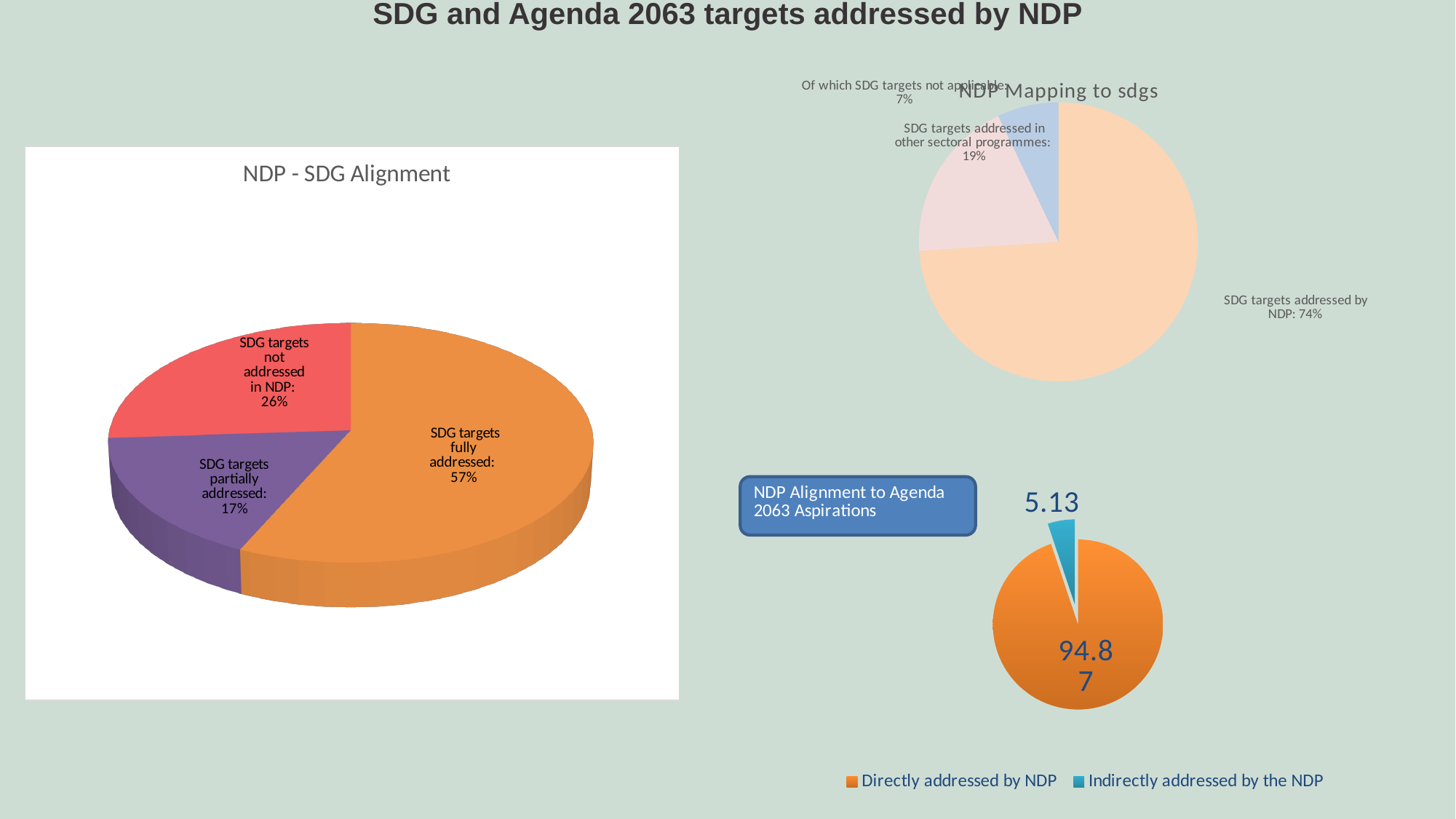
What type of chart is 'NDP - SDG Alignment'? Pie chart In the 'NDP - SDG Alignment' chart, what share of SDG targets are partially addressed? 17% In the 'NDP Mapping to sdgs' chart, what share of SDG targets are addressed in other sectoral programmes? 19% In the 'NDP Alignment to Agenda 2063 Aspirations' chart, what is the value for 'Directly addressed by NDP'? 94.87 In the 'NDP - SDG Alignment' chart, what share of SDG targets are fully addressed? 57% In the 'NDP Mapping to sdgs' chart, what share of SDG targets are addressed by NDP? 74% In the 'NDP Mapping to sdgs' chart, which category has the smallest slice? Of which SDG targets not applicable How many series does the legend of the 'NDP Alignment to Agenda 2063 Aspirations' chart list? 2 In the 'NDP - SDG Alignment' chart, which category has the largest slice? SDG targets fully addressed In the 'NDP - SDG Alignment' chart, what is the difference between the share of SDG targets not addressed in NDP and the share partially addressed? 9% How many slices does the 'NDP - SDG Alignment' pie chart have? 3 In the 'NDP - SDG Alignment' chart, which category has the smallest slice? SDG targets partially addressed